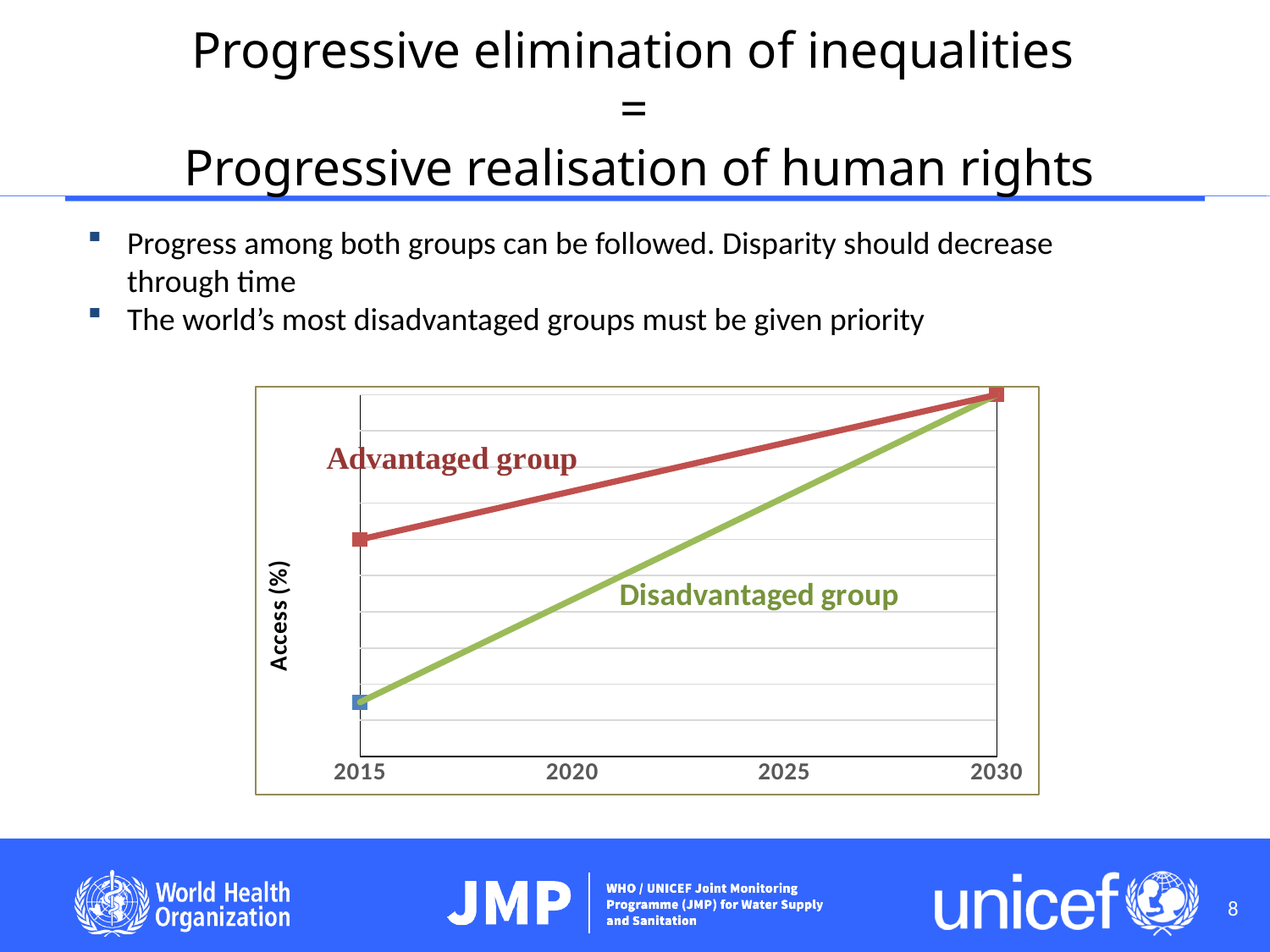
Which group's line rises more steeply between 2015 and 2030? Disadvantaged group What are the names of the two groups plotted on the chart? Advantaged group and Disadvantaged group How many series are plotted on the chart? 2 Does access for the Advantaged group rise or fall from 2015 to 2030? Rise How many year labels are shown on the x axis of the chart? 4 What is the first year shown on the x axis of the chart? 2015 What kind of chart is shown on the slide? Line chart Does access for the Disadvantaged group rise or fall from 2015 to 2030? Rise In 2015, which group has higher access: the Advantaged group or the Disadvantaged group? Advantaged group What is the last year shown on the x axis of the chart? 2030 What is the label on the vertical axis of the chart? Access (%) In which year do the two groups' lines meet at the same access level? 2030